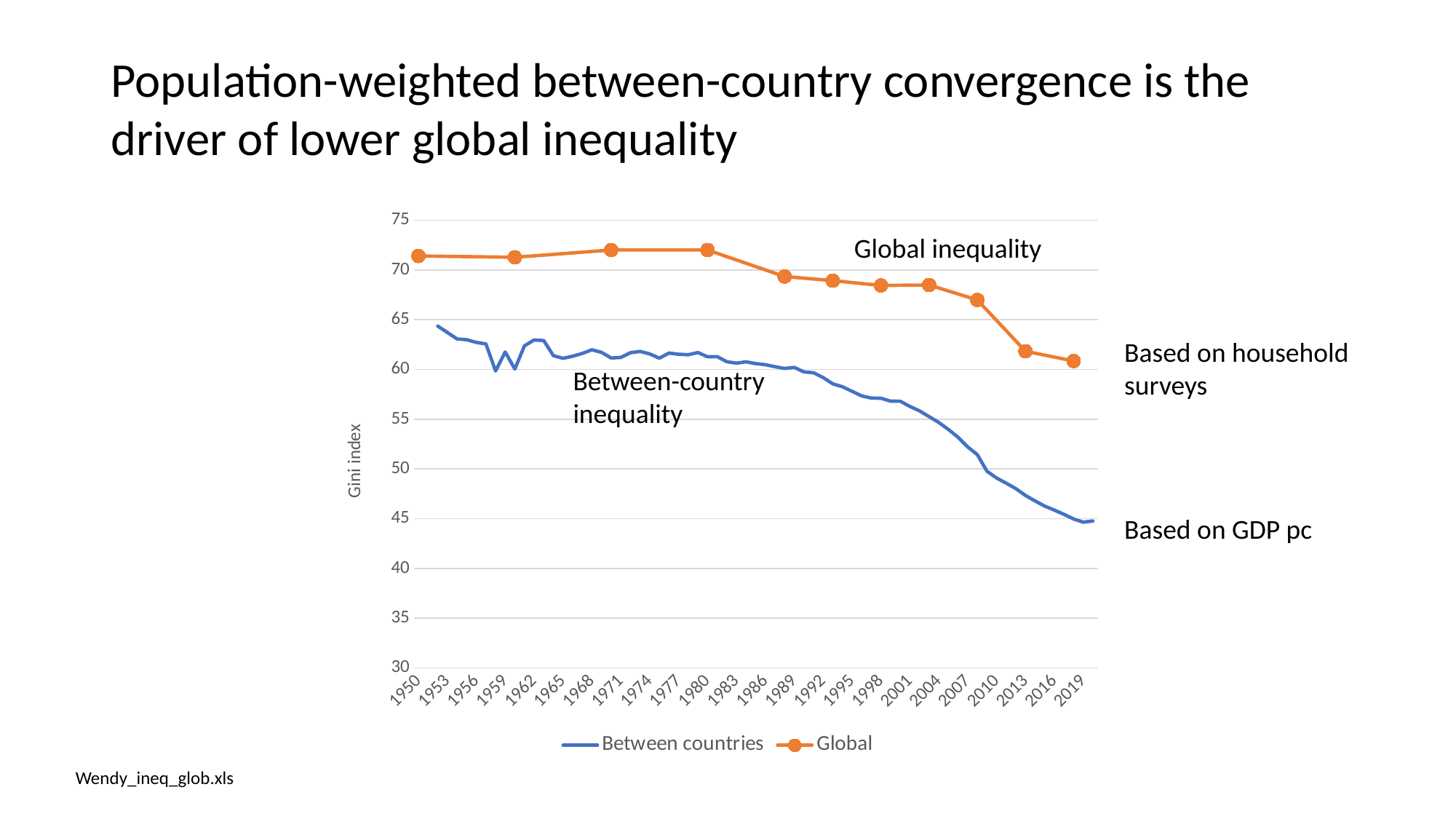
Is the value for Between countries in 1950 greater or less than 60? greater How many series does the legend list? 2 Is the last plotted value for Global greater or less than 65? less Does the Global series rise or fall overall from 1950 to 2019? fall Which series is higher at the right end of the chart, Between countries or Global? Global What type of chart is shown on the slide? line chart What is the title of the vertical axis? Gini index Which series has the higher value in 1950, Between countries or Global? Global Does the Between countries series rise or fall from 1950 to 2019? fall Is the value for Global in 1950 greater or less than 70? greater What are the two series named in the legend? Between countries and Global